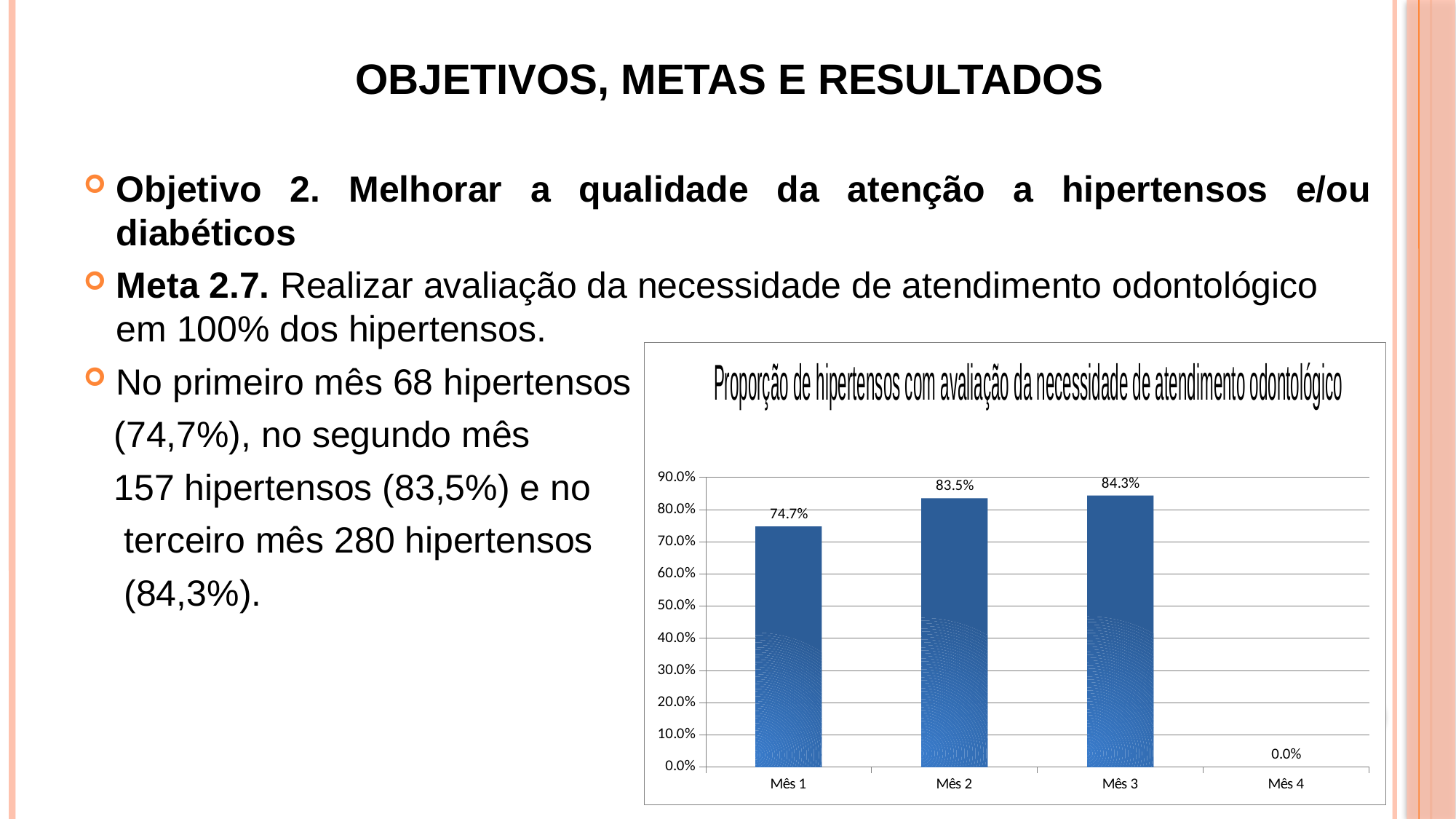
What is the value for Mês 1? 74.7% What is the value for Mês 3? 84.3% Do the values rise or fall from Mês 1 to Mês 3? Rise Which month has the highest value? Mês 3 How many months are shown on the x axis? 4 What kind of chart is shown on the slide? Bar chart What is the value for Mês 2? 83.5% Which is larger, the value for Mês 1 or the value for Mês 2? Mês 2 What is the value for Mês 4? 0.0% What is the difference between the values for Mês 2 and Mês 1? 8.8 percentage points Which month has the lowest value? Mês 4 What is the difference between the values for Mês 3 and Mês 1? 9.6 percentage points